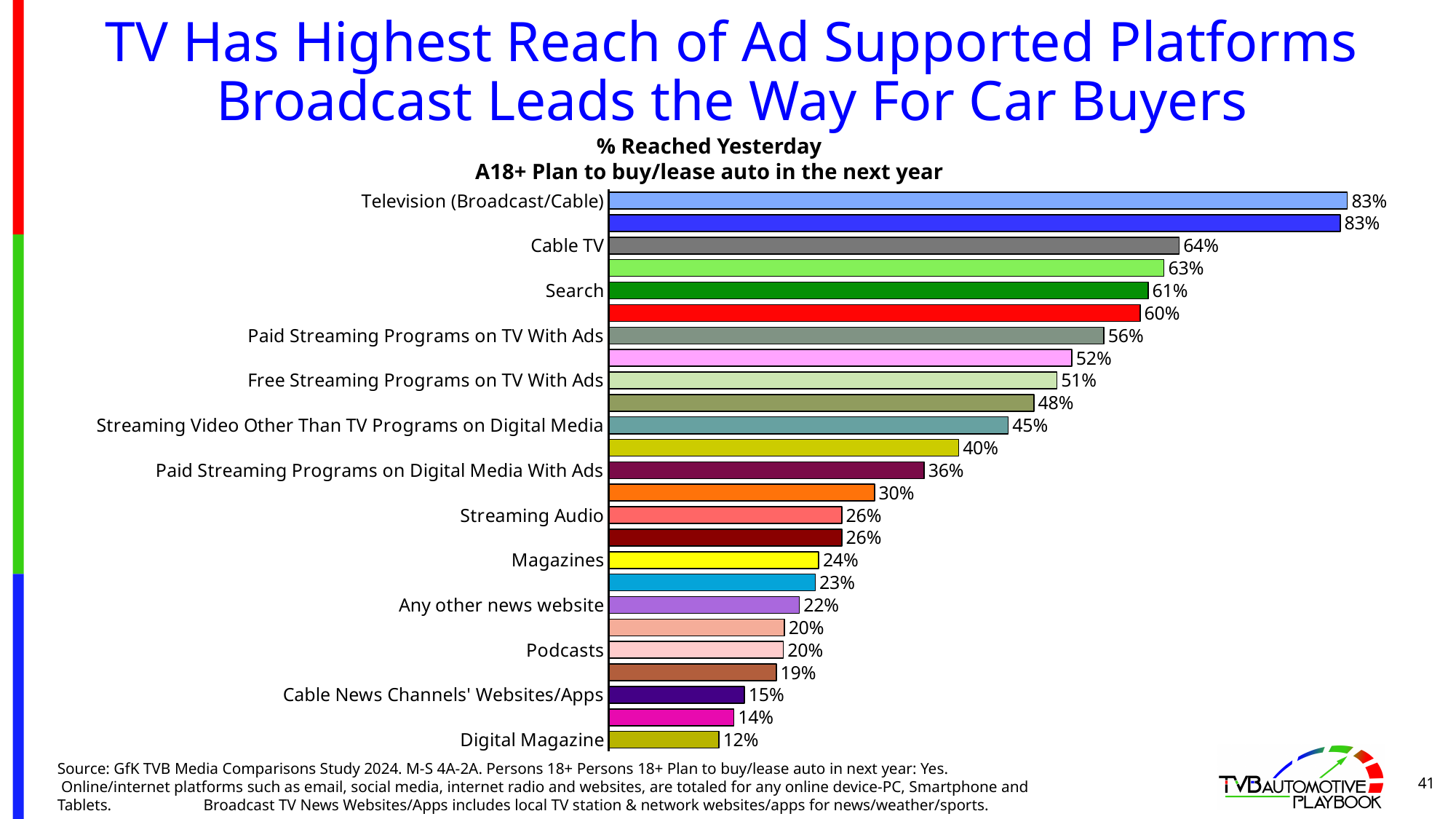
Which labeled category has the lowest value? Digital Magazine What is the difference between the values for Television (Broadcast/Cable) and Digital Magazine? 71% What is the value for Search? 61% What is the value for Cable TV? 64% What is the value for Podcasts? 20% What is the subtitle printed above the chart describing the audience? A18+ Plan to buy/lease auto in the next year What is the value for Paid Streaming Programs on TV With Ads? 56% What kind of chart is shown on the slide? bar chart What is the value for Streaming Audio? 26% Which is larger, the value for Magazines or the value for Podcasts? Magazines What is the value for Television (Broadcast/Cable)? 83% What is the difference between the values for Cable TV and Search? 3%